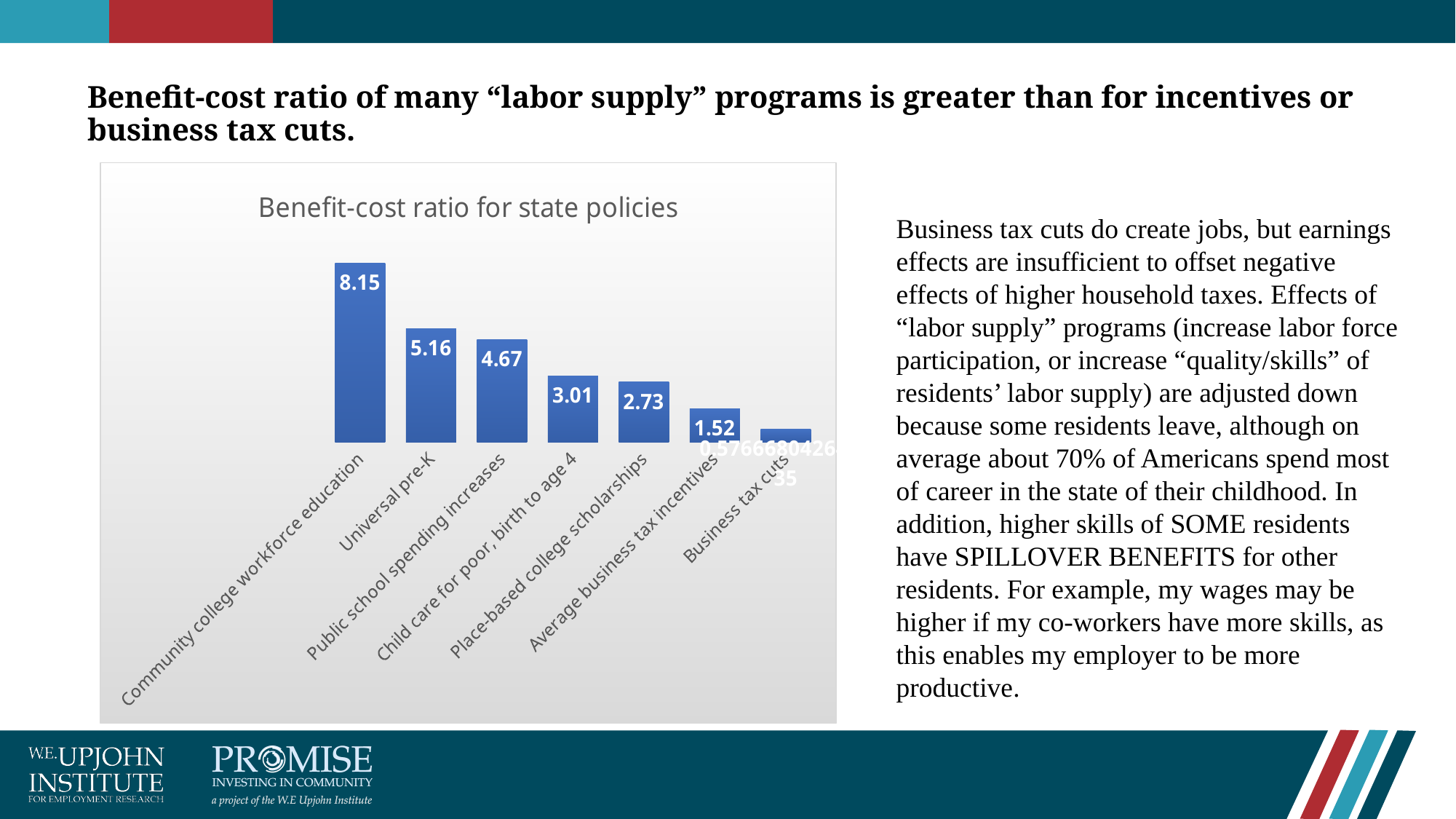
What is the benefit-cost ratio for Universal pre-K? 5.16 What is the benefit-cost ratio for Community college workforce education? 8.15 What is the benefit-cost ratio for Child care for poor, birth to age 4? 3.01 Which policy has the lowest benefit-cost ratio? Business tax cuts What is the difference between the benefit-cost ratios of Universal pre-K and Place-based college scholarships? 2.43 What type of chart is used to show the benefit-cost ratios? Bar chart How many policies are shown in the chart? 7 Which has a larger benefit-cost ratio, Public school spending increases or Average business tax incentives? Public school spending increases What is the benefit-cost ratio for Average business tax incentives? 1.52 What is the title of the chart? Benefit-cost ratio for state policies Which policy has the highest benefit-cost ratio? Community college workforce education What is the benefit-cost ratio for Public school spending increases? 4.67